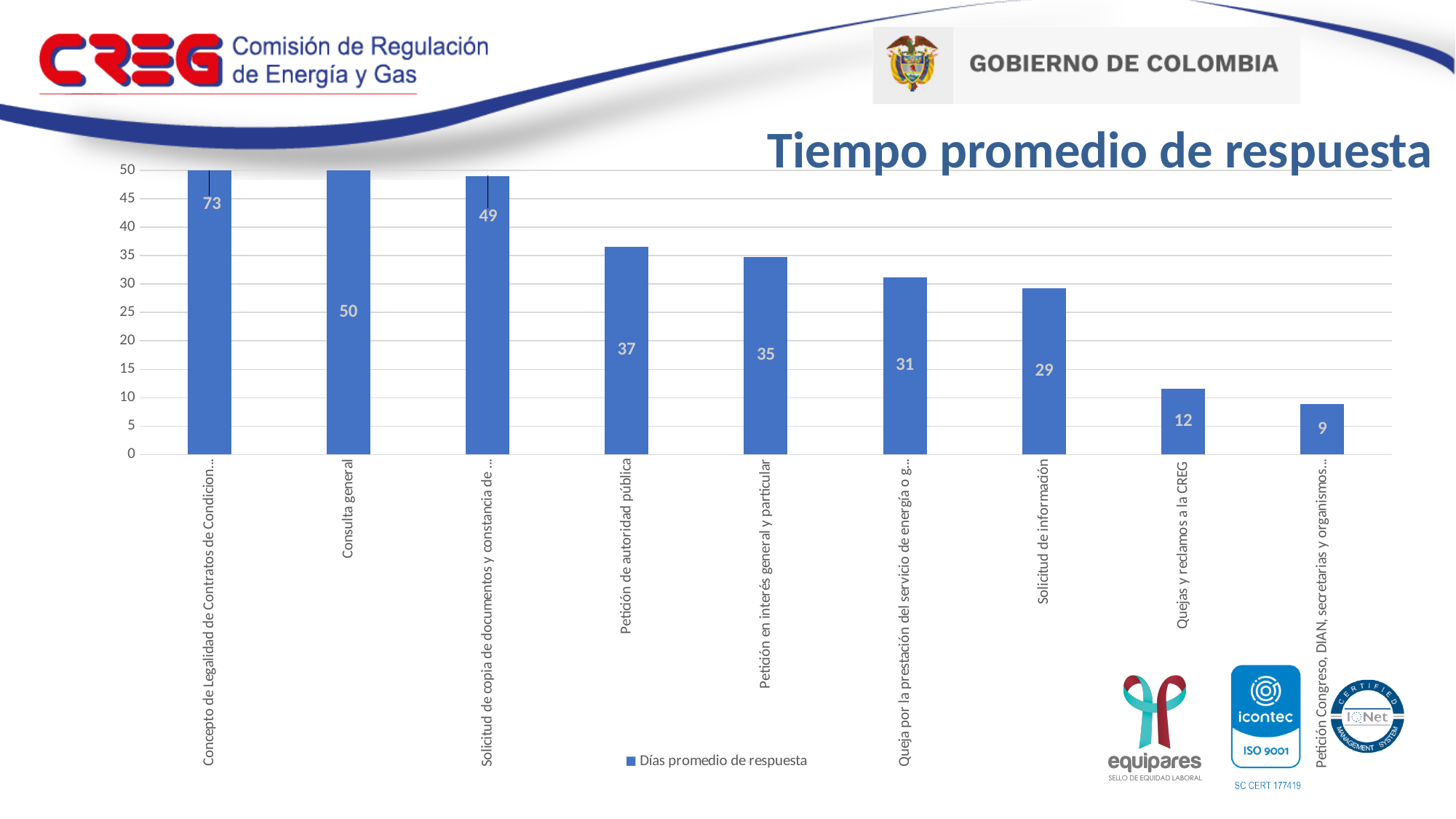
Do the values rise or fall from left to right along the x axis? Fall What is the difference between the values for Consulta general and Solicitud de información? 21 How many categories are shown in the chart? 9 What kind of chart is shown on the slide? Bar chart What is the value for Quejas y reclamos a la CREG? 12 What is the value for Solicitud de información? 29 What is the value for Petición de autoridad pública? 37 Which category has the highest value? Concepto de Legalidad de Contratos de Condicion... How many series does the legend list? 1 What is the value for Consulta general? 50 Which category has the lowest value? Petición Congreso, DIAN, secretarias y organismos... Which is larger: the value for Petición de autoridad pública or the value for Petición en interés general y particular? Petición de autoridad pública